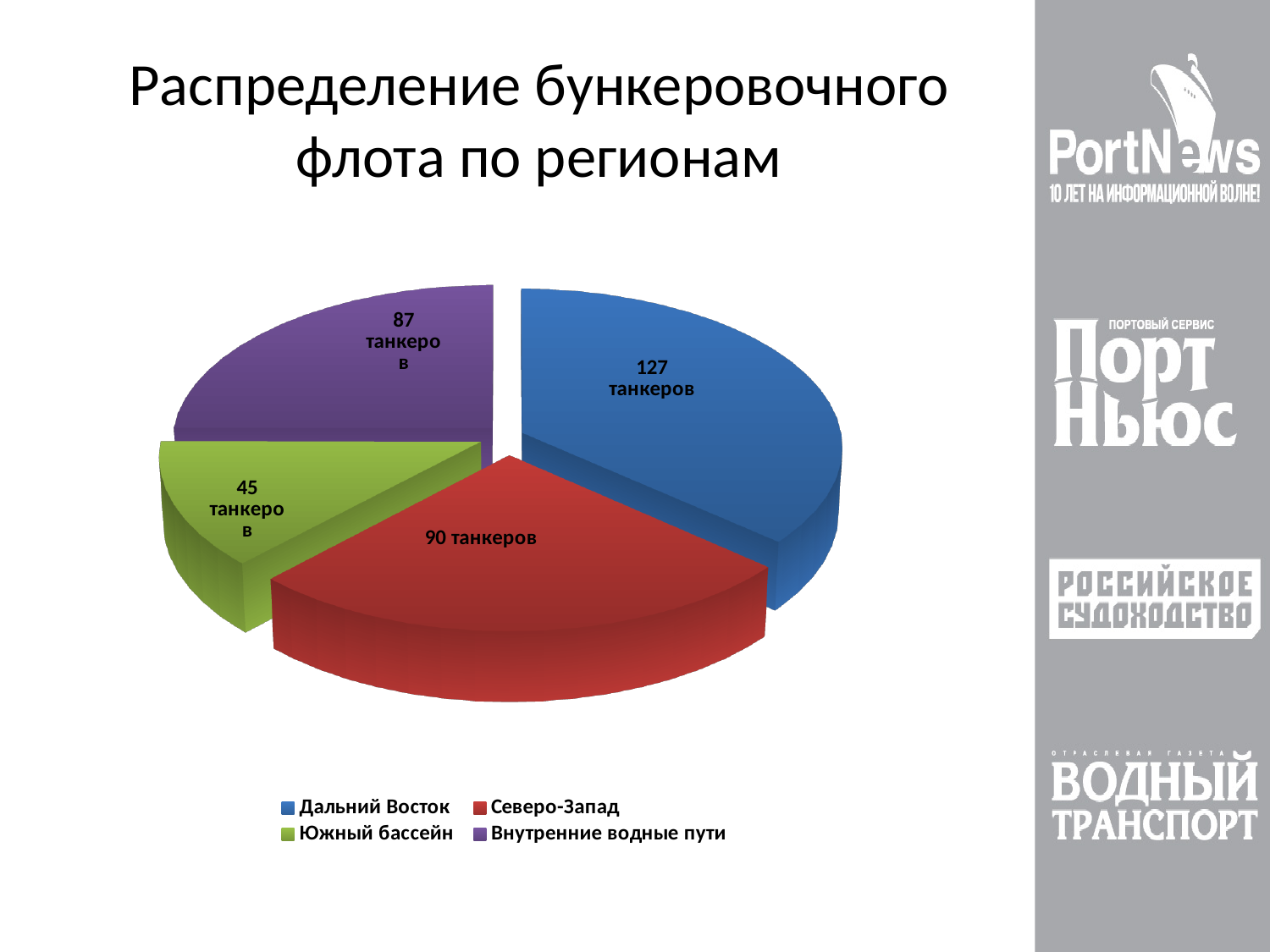
How many tankers are shown for Дальний Восток? 127 танкеров How many tankers are shown for Внутренние водные пути? 87 танкеров What is the difference in tankers between Дальний Восток and Северо-Запад? 37 How many regions are shown in the pie chart? 4 How many tankers are shown for Северо-Запад? 90 танкеров Which has more tankers, Северо-Запад or Внутренние водные пути? Северо-Запад How many tankers are shown for Южный бассейн? 45 танкеров What is the total number of tankers across all four regions? 349 Which region has the largest number of tankers? Дальний Восток What colour is the slice for Внутренние водные пути? Purple Which region has the smallest number of tankers? Южный бассейн What type of chart is shown on the slide? Pie chart